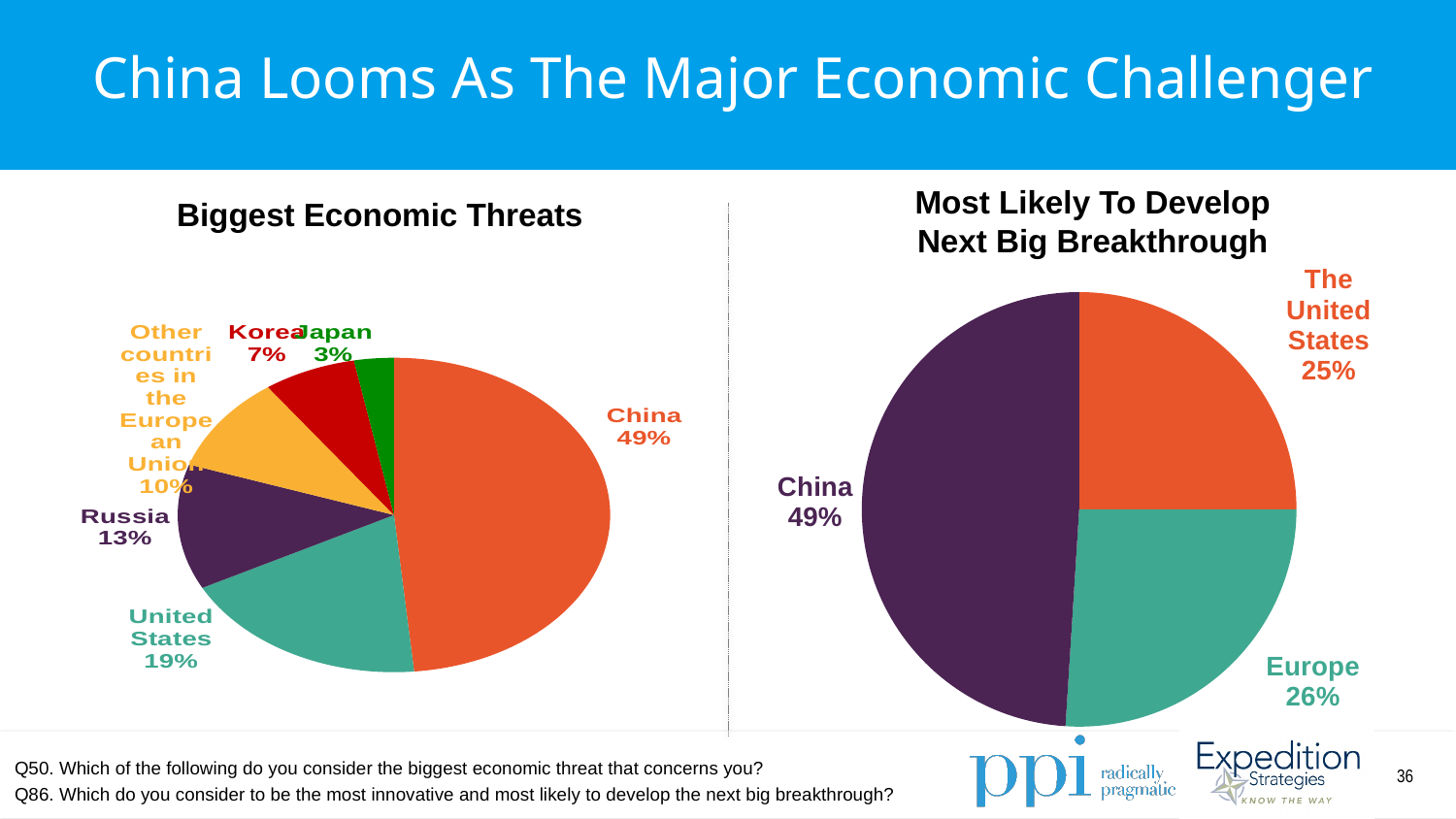
In the 'Most Likely To Develop Next Big Breakthrough' chart, which category has the largest share? China In the 'Biggest Economic Threats' chart, which category has the largest slice? China In the 'Most Likely To Develop Next Big Breakthrough' chart, what is the difference between China and Europe? 23% In the 'Biggest Economic Threats' chart, what is the difference between the United States and Russia values? 6% In the 'Biggest Economic Threats' chart, how many categories are shown? 6 What type of chart is used for 'Biggest Economic Threats'? Pie chart In the 'Most Likely To Develop Next Big Breakthrough' chart, what is the value for The United States? 25% In the 'Biggest Economic Threats' chart, what share of respondents named China? 49% In the 'Biggest Economic Threats' chart, which category has the smallest slice? Japan In the 'Most Likely To Develop Next Big Breakthrough' chart, what is the value for Europe? 26% In the 'Biggest Economic Threats' chart, what is the value for Russia? 13% In the 'Most Likely To Develop Next Big Breakthrough' chart, how many categories are shown? 3